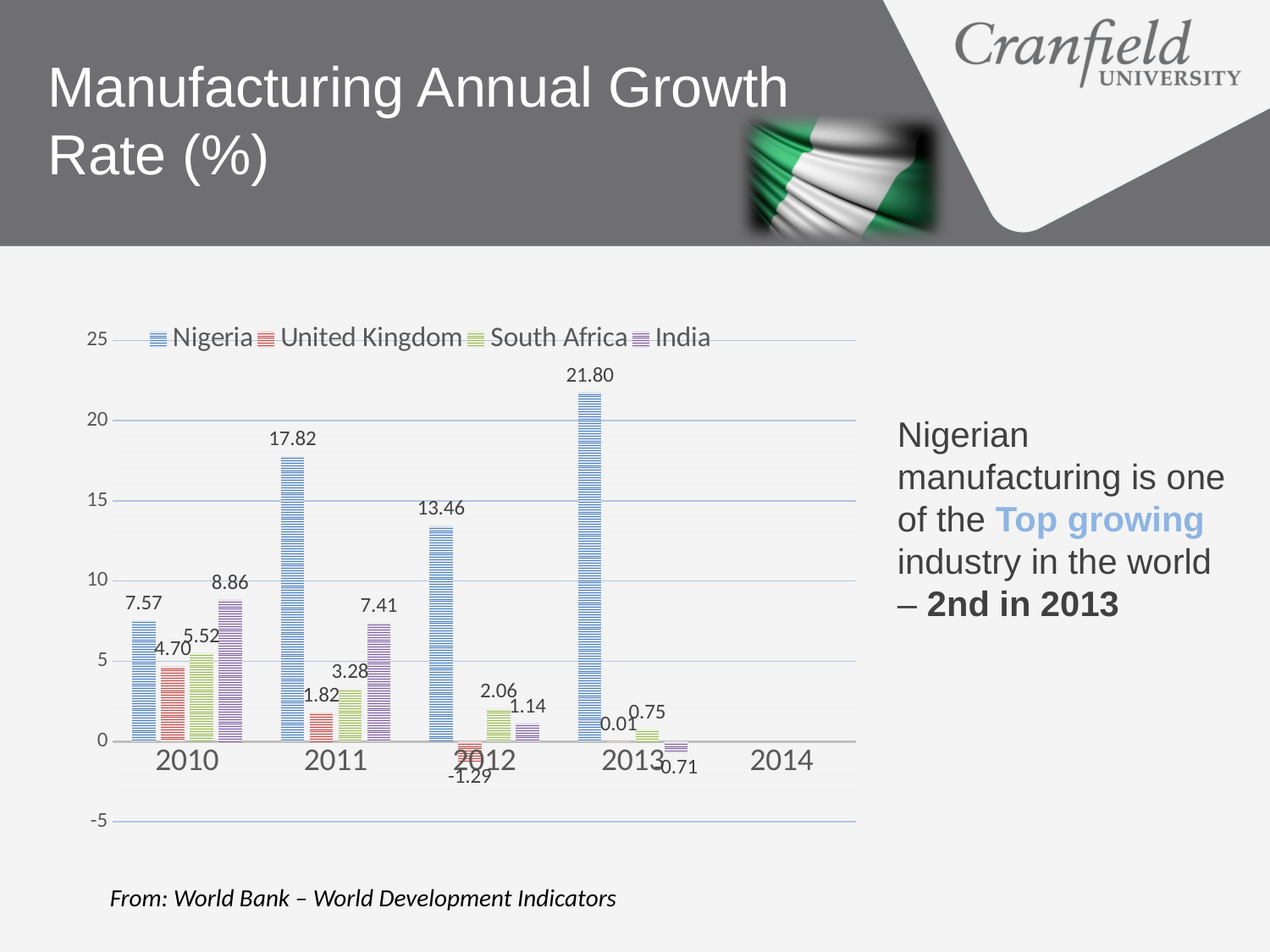
What is the value for South Africa in 2012? 2.06 What is the difference between Nigeria's value in 2013 and its value in 2011? 3.98 How many series does the legend list? 4 Do South Africa's values rise or fall from 2010 to 2013? Fall What is the manufacturing annual growth rate for Nigeria in 2013? 21.80 What is the value for the United Kingdom in 2011? 1.82 Which country has the highest growth rate in 2011? Nigeria In 2010, which is larger: the value for India or the value for Nigeria? India What kind of chart is shown on the slide? Bar chart In which year is Nigeria's growth rate highest? 2013 What is the value for India in 2010? 8.86 Which country has the lowest value in 2013? India